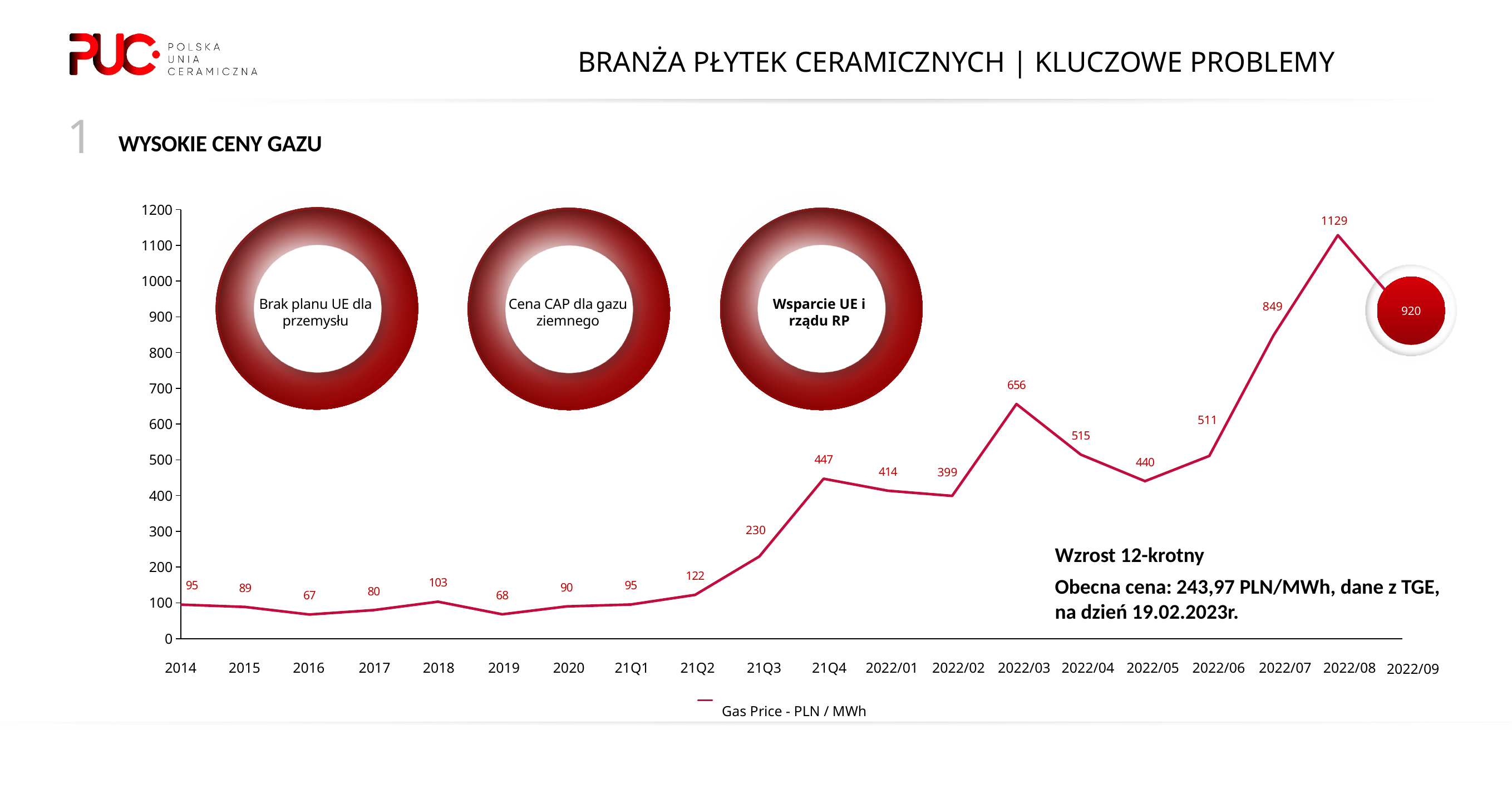
What kind of chart is shown on the slide? line chart What is the gas price value shown for 21Q4? 447 Which period has the lowest gas price on the chart? 2016 What is the gas price value shown for 2022/09? 920 What is the gas price value shown for 2022/08? 1129 How many series does the chart legend list? 1 What is the difference between the gas price in 2022/08 and in 2022/09? 209 What is the difference between the gas price in 2022/03 and in 2022/02? 257 Which is larger, the gas price in 2022/04 or in 2022/06? 2022/04 Which period has the highest gas price on the chart? 2022/08 How many periods are plotted on the x axis of the chart? 20 Is the gas price for 2022/07 greater or less than 800? greater